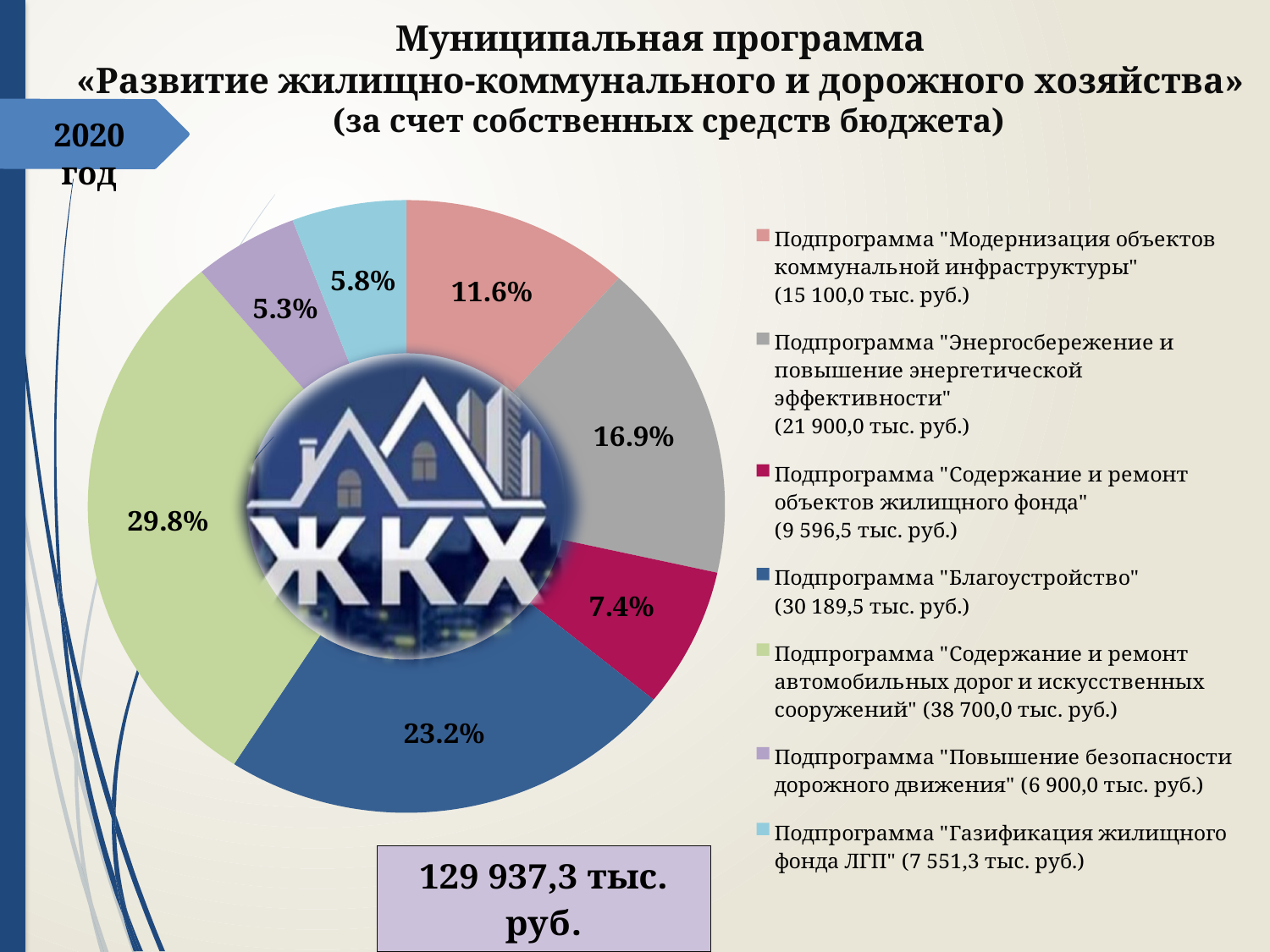
What percentage is shown for the subprogram "Содержание и ремонт автомобильных дорог и искусственных сооружений"? 29.8% What share of the pie chart does the subprogram "Благоустройство" account for? 23.2% Which subprogram has the largest share of the pie chart? Подпрограмма "Содержание и ремонт автомобильных дорог и искусственных сооружений" Which subprogram has the smallest share of the pie chart? Подпрограмма "Повышение безопасности дорожного движения" How many subprograms (slices) are shown in the pie chart? 7 What total amount is shown in the box below the pie chart? 129 937,3 тыс. руб. What kind of chart is shown on the slide? Doughnut chart Which year is indicated on the slide for the program data? 2020 год Which has a larger share: "Модернизация объектов коммунальной инфраструктуры" or "Газификация жилищного фонда ЛГП"? Модернизация объектов коммунальной инфраструктуры What is the difference in percentage points between the shares of "Благоустройство" and "Содержание и ремонт объектов жилищного фонда"? 15.8 What percentage is shown for the subprogram "Энергосбережение и повышение энергетической эффективности"? 16.9% What amount in thousand rubles is listed in the legend for the subprogram "Благоустройство"? 30 189,5 тыс. руб.